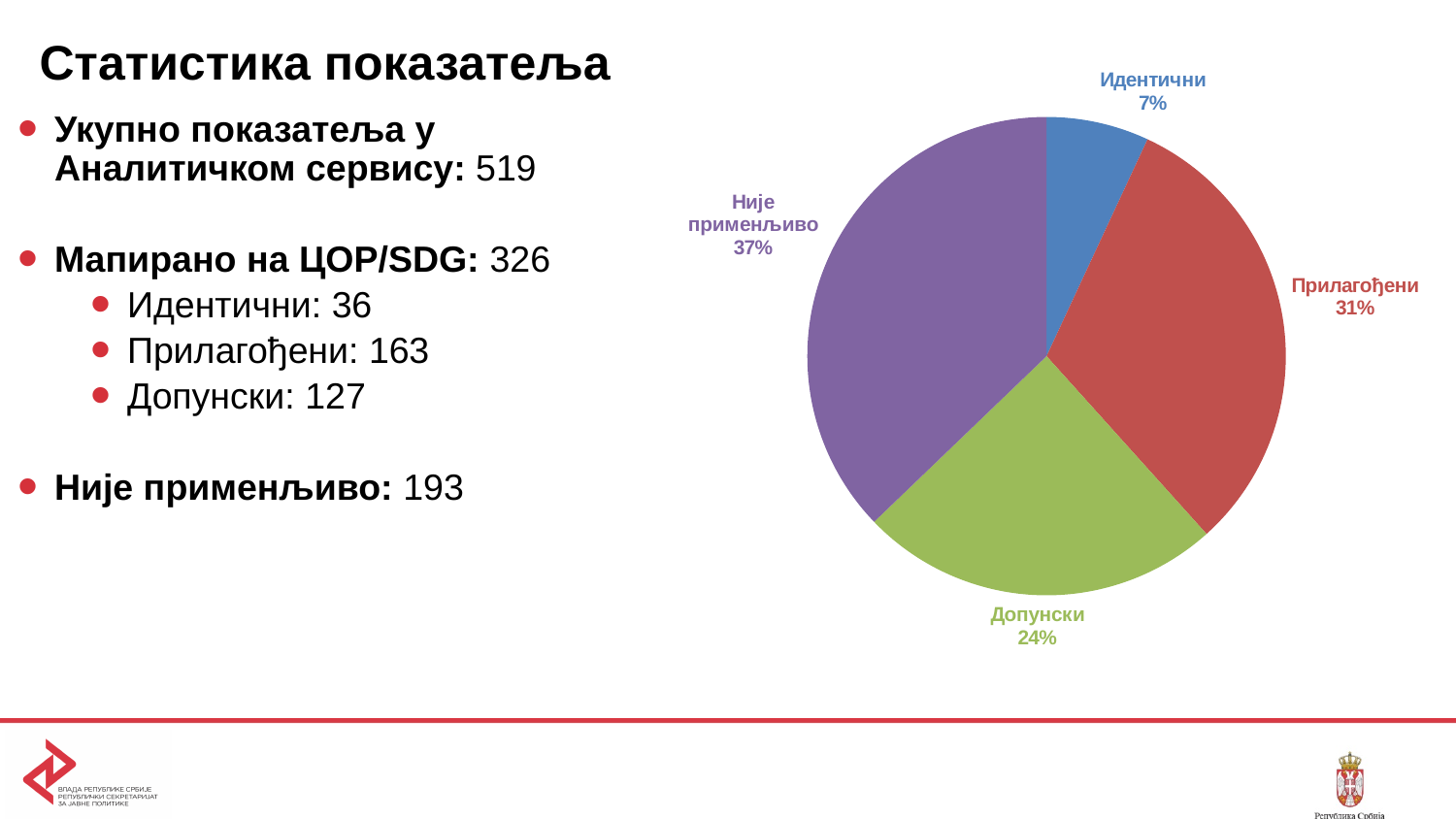
What is the difference in percentage points between the Прилагођени and Допунски slices? 7 What colour is the Допунски slice in the pie chart? green What share of the pie does the Прилагођени slice represent? 31% What share of the pie does the Није применљиво slice represent? 37% Which slice of the pie chart is the smallest? Идентични Which slice of the pie chart is the largest? Није применљиво What share of the pie does the Идентични slice represent? 7% How many slices does the pie chart have? 4 What kind of chart is shown on the slide? pie chart What is the difference in percentage points between the Није применљиво and Идентични slices? 30 Which slice is larger, Прилагођени or Допунски? Прилагођени